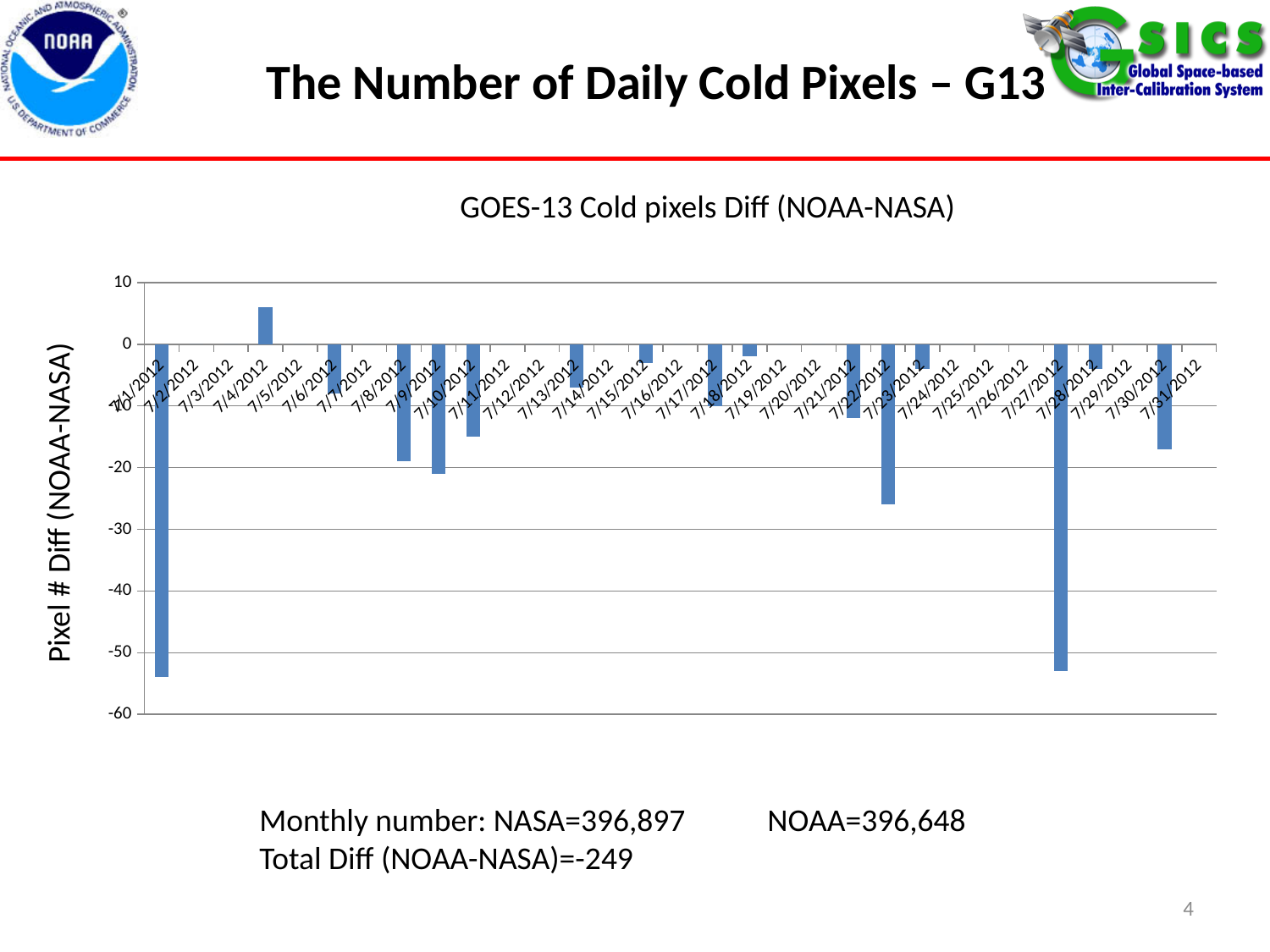
What kind of chart is shown on the slide? bar chart What is the title of the chart? GOES-13 Cold pixels Diff (NOAA-NASA) Is the value for 7/10/2012 greater or less than -10? less Is the value for 7/22/2012 greater or less than -20? less How many dates are shown along the x axis of the chart? 31 Which date has the highest value in the chart? 7/4/2012 What is the label on the vertical axis of the chart? Pixel # Diff (NOAA-NASA) Which has the larger value, 7/8/2012 or 7/22/2012? 7/8/2012 Is the value for 7/1/2012 greater or less than -50? less Which has the larger value, 7/4/2012 or 7/6/2012? 7/4/2012